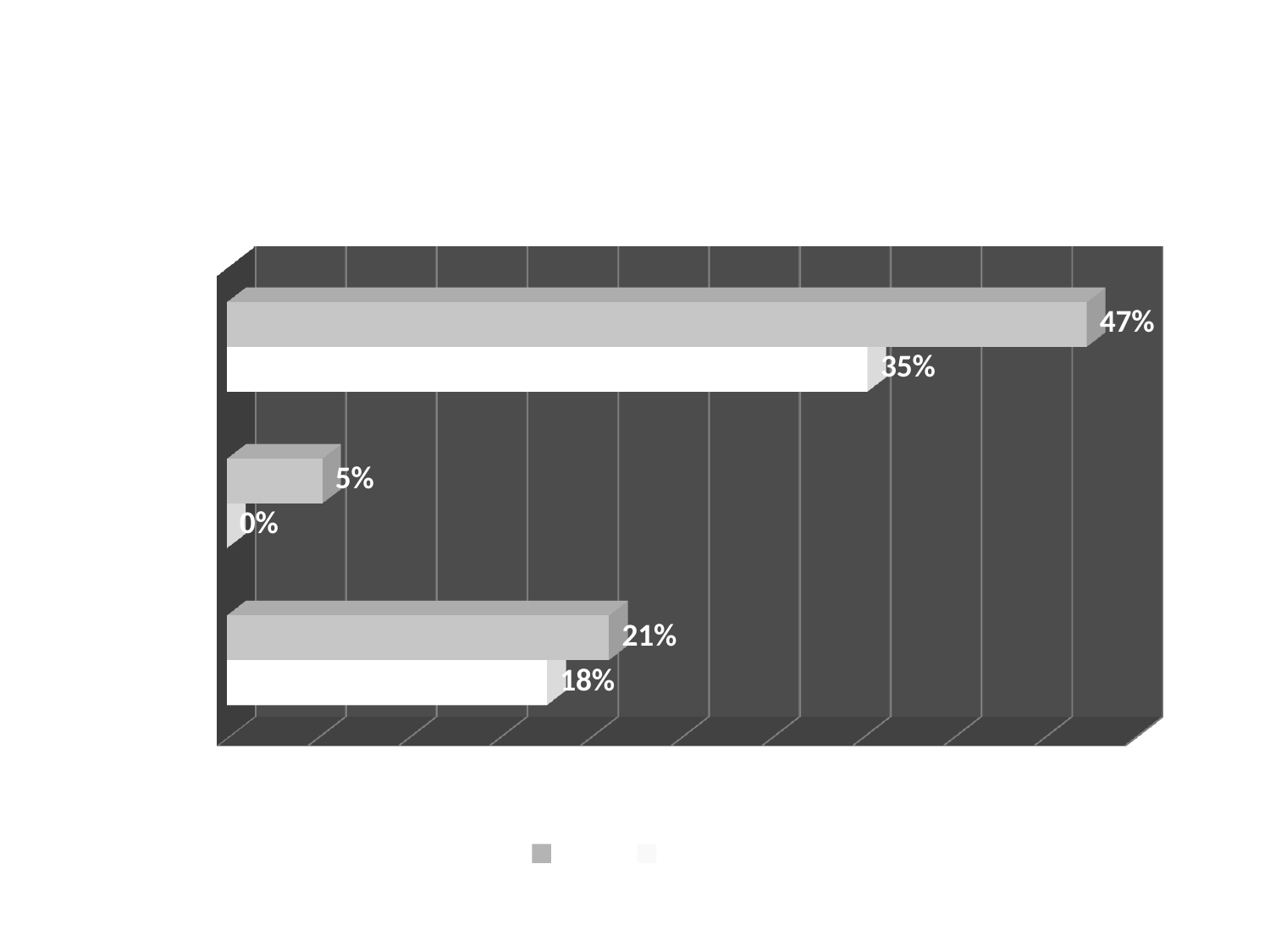
What is the value of the grey bar in the top group? 47% What is the value of the grey bar in the middle group? 5% How many groups of bars (categories) does the chart show? 3 What is the difference between the grey bar and the white bar in the top group? 12% Which group of bars has the highest grey-bar value? the top group What is the value of the grey bar in the bottom group? 21% In the bottom group, which bar is larger, the grey bar or the white bar? the grey bar What is the value of the white bar in the bottom group? 18% What is the value of the white bar in the middle group? 0% How many series does the legend list? 2 What kind of chart is shown on the slide? bar chart What is the value of the white bar in the top group? 35%